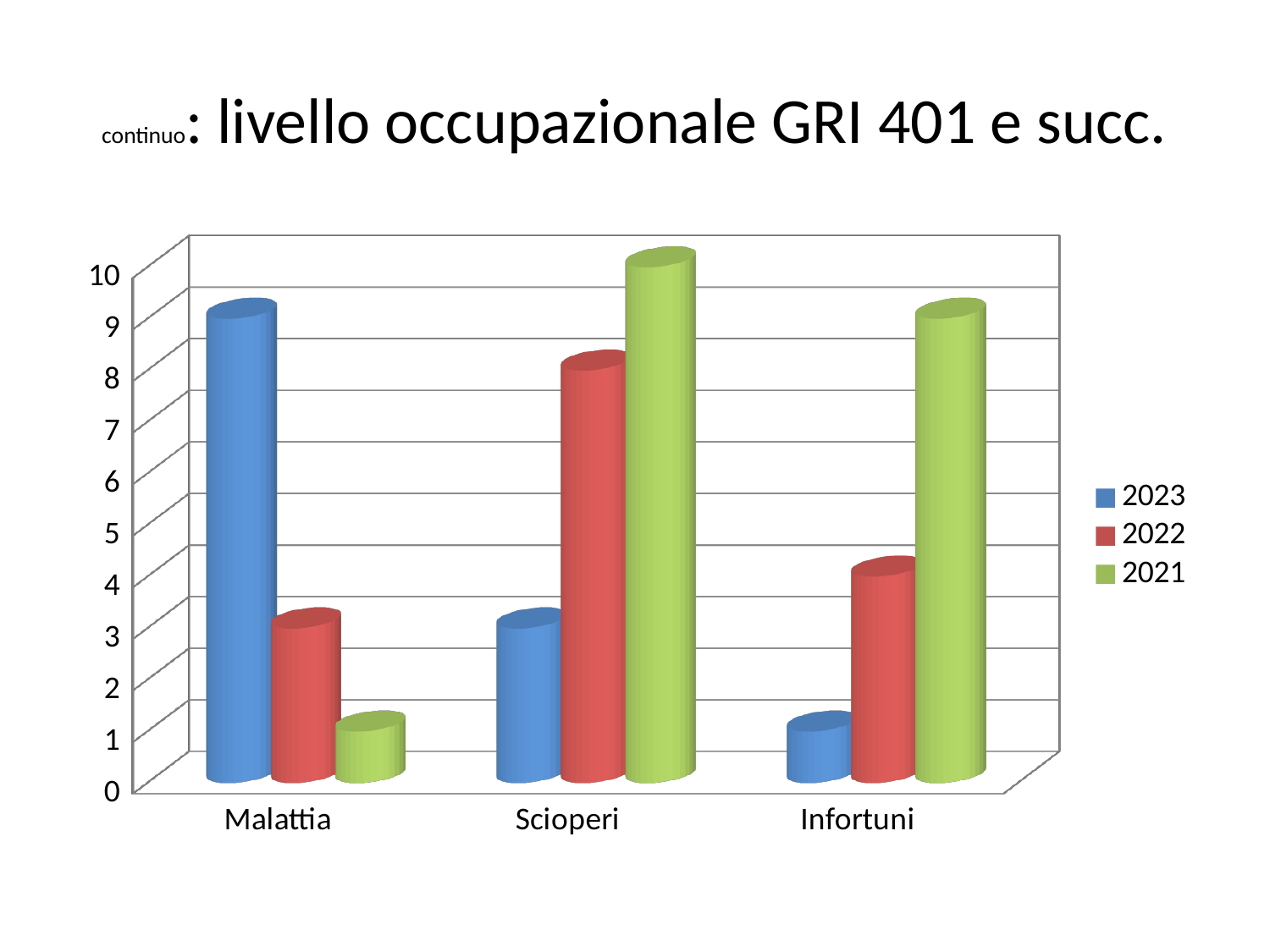
Which category has the highest value for the 2023 series? Malattia Is the value for Malattia in 2021 greater or less than 2? less What kind of chart is shown on the slide? bar chart How many series does the legend list? 3 Which colour represents the 2021 series? green Is the value for Malattia in 2023 greater or less than 5? greater For Infortuni, which is larger: the 2022 value or the 2021 value? 2021 Which category has the lowest value for the 2021 series? Malattia Is the value for Scioperi in 2021 greater or less than 8? greater How many categories are shown on the x axis of the chart? 3 Which series are listed in the legend? 2023, 2022, 2021